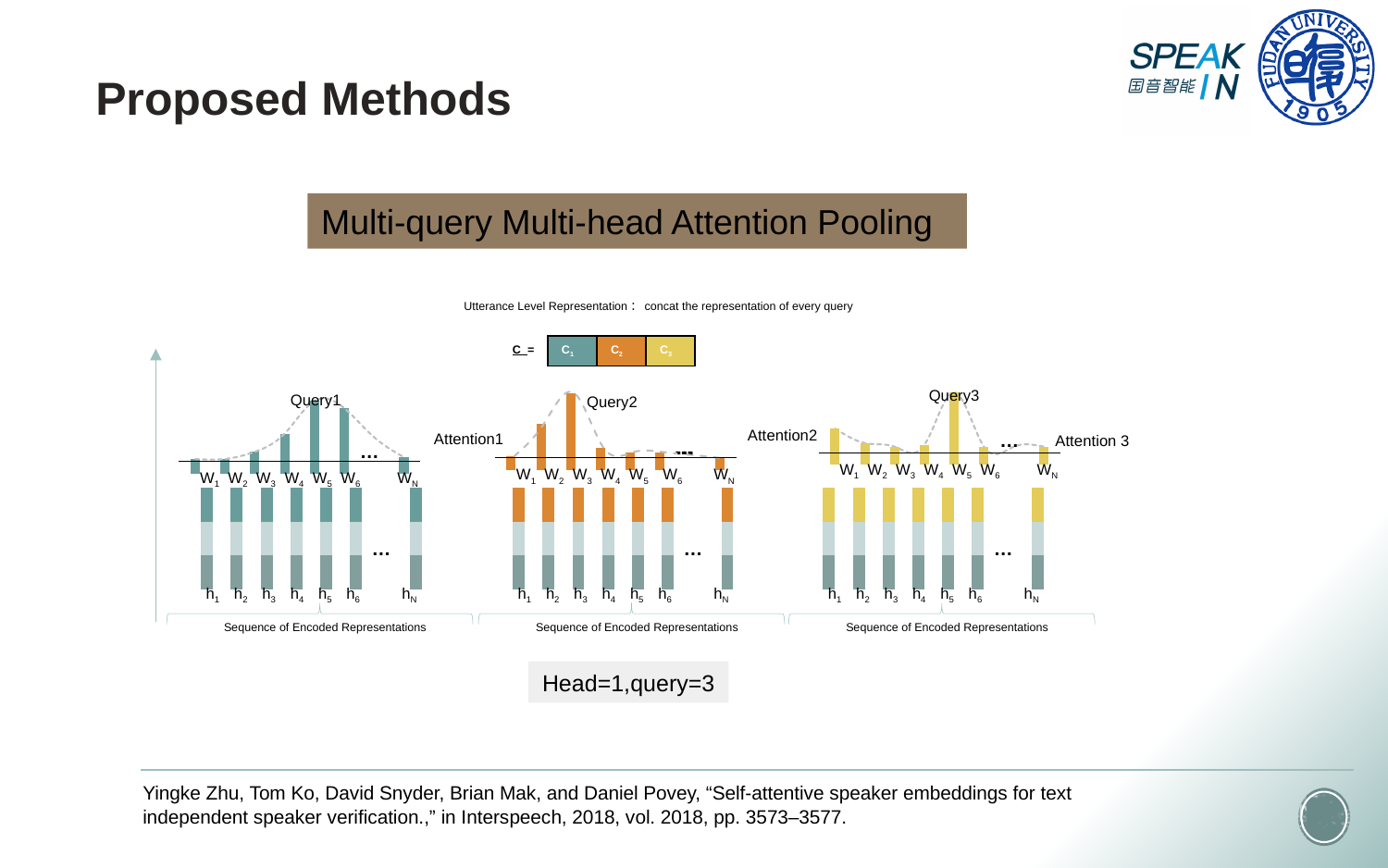
In the Query2 attention diagram, is the bar for W3 taller or shorter than the bar for W6? taller In the Query1 attention diagram, which labeled weight (W1 to W6) has the tallest bar? W5 What is the title shown in the box above the diagrams? Multi-query Multi-head Attention Pooling In the Query3 attention diagram, which labeled weight (W1 to W6) has the tallest bar? W5 What colour are the attention weight bars in the Query2 diagram? orange How many labeled weight positions (W1 through W6 plus WN) are shown in each attention diagram? 7 In the Query2 attention diagram, which labeled weight (W1 to W6) has the tallest bar? W3 In the Query1 attention diagram, is the bar for W5 taller or shorter than the bar for W1? taller How many attention diagrams (queries) are shown on the slide? 3